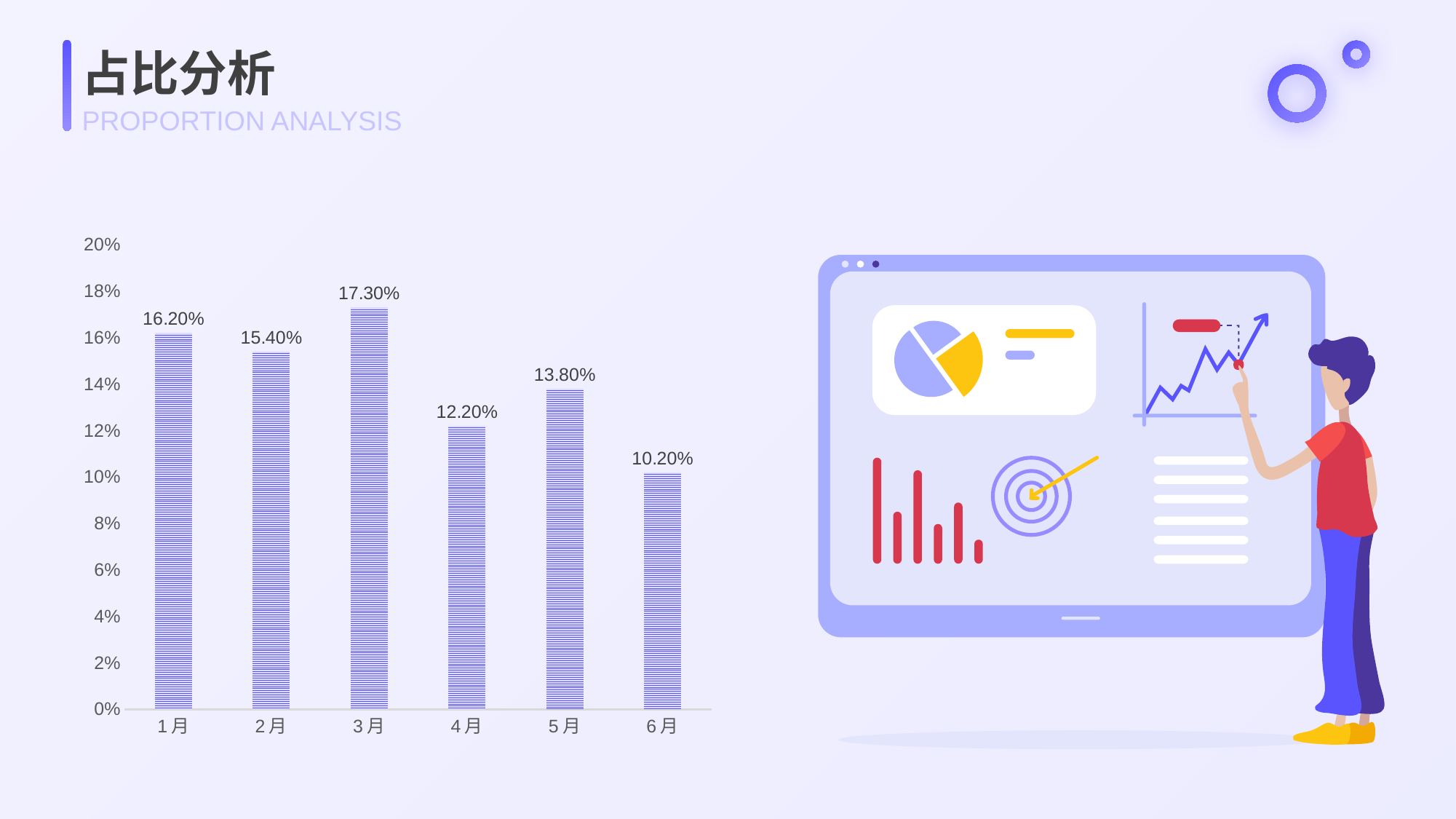
Is the value for 2月 greater or less than 14%? greater Which is larger, the value for 4月 or the value for 5月? 5月 What is the difference between the values for 3月 and 6月? 7.10% Which month has the lowest value? 6月 Which month has the highest value? 3月 What kind of chart is shown on the slide? bar chart What is the difference between the values for 1月 and 2月? 0.80% What is the value for 6月? 10.20% How many months are shown on the x axis? 6 What is the value for 3月? 17.30% What is the value for 1月? 16.20%